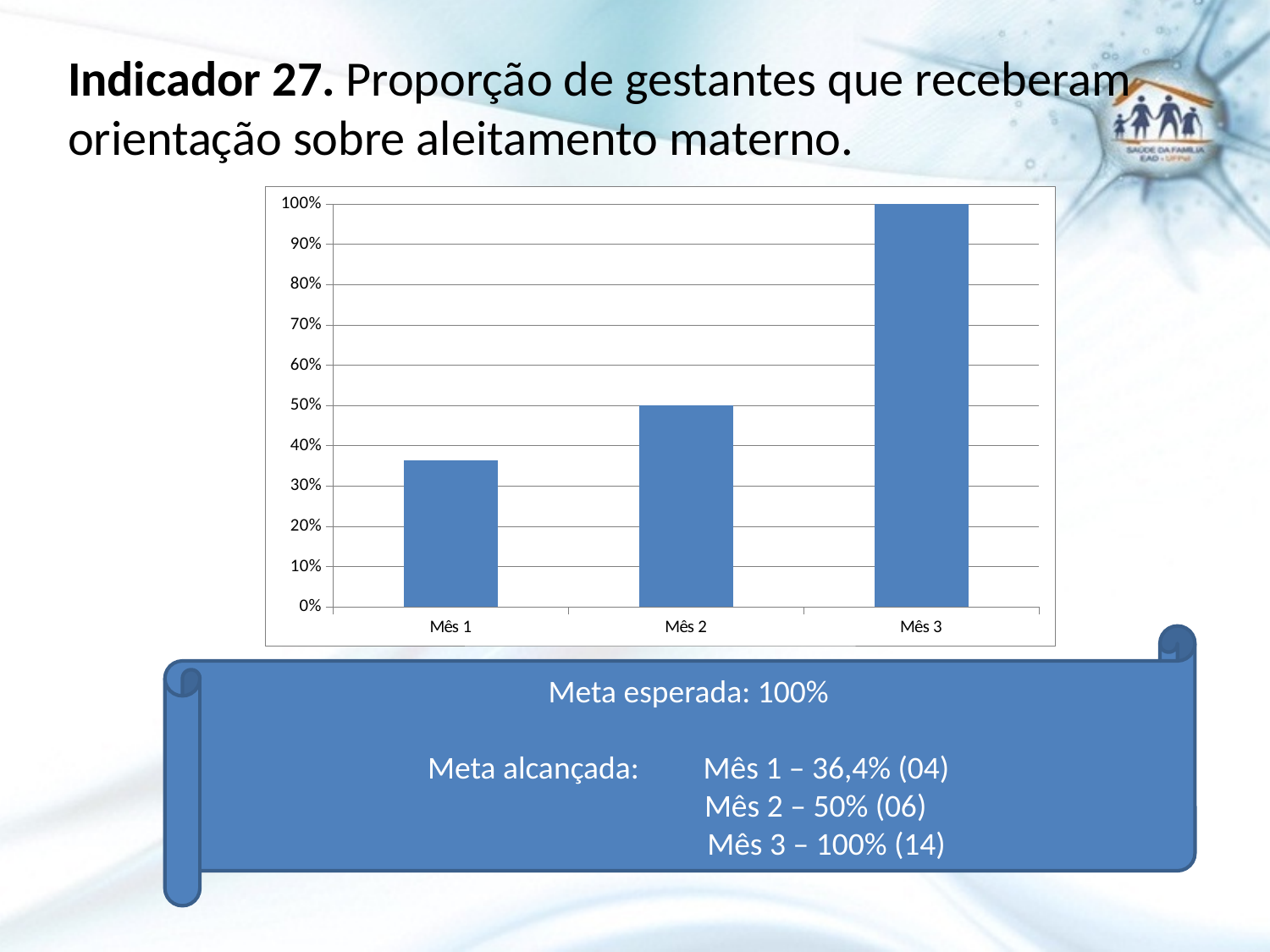
What is the difference between the values for Mês 3 and Mês 2? 50% How many categories (months) are plotted on the chart? 3 Which month has the lowest value on the chart? Mês 1 Which month has the highest value on the chart? Mês 3 What is the value for Mês 3? 100% What is the expected target (Meta esperada) stated on the slide? 100% Is the value for Mês 1 greater or less than 40%? less Do the values rise or fall from Mês 1 to Mês 3? rise What is the value for Mês 2? 50% What kind of chart is shown on the slide? bar chart What is the value for Mês 1, as printed on the slide? 36,4% Which is larger, the value for Mês 2 or the value for Mês 3? Mês 3